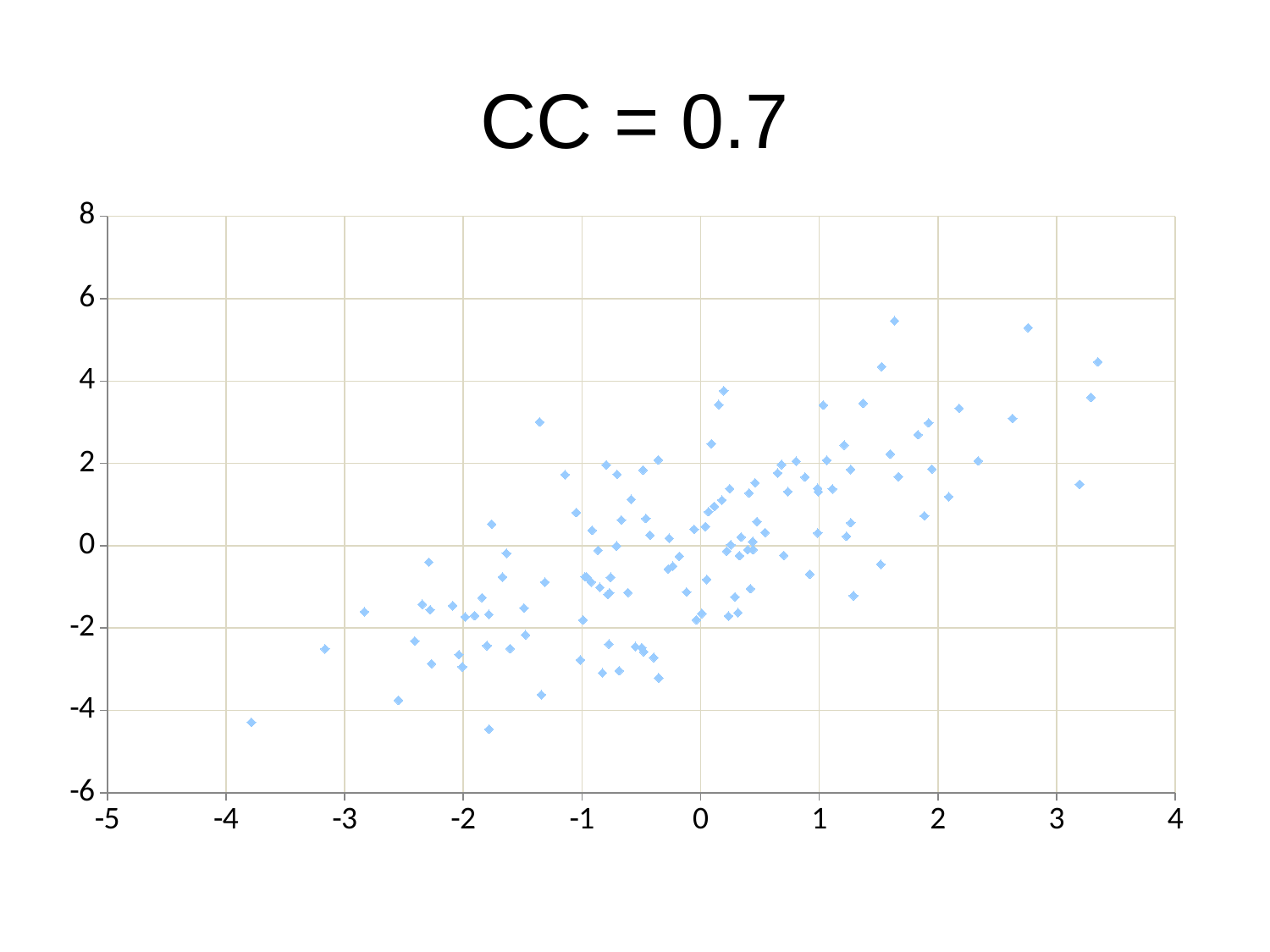
Is the y value of the highest point on the chart greater or less than 4? greater What is the maximum value shown on the y axis? 8 Is the x value of the leftmost point on the chart greater or less than -3? less What is the title of the chart? CC = 0.7 Is the y value of the lowest point on the chart greater or less than -2? less What kind of chart is shown on the slide? scatter plot Do the y values generally rise or fall as x increases along the x axis? rise